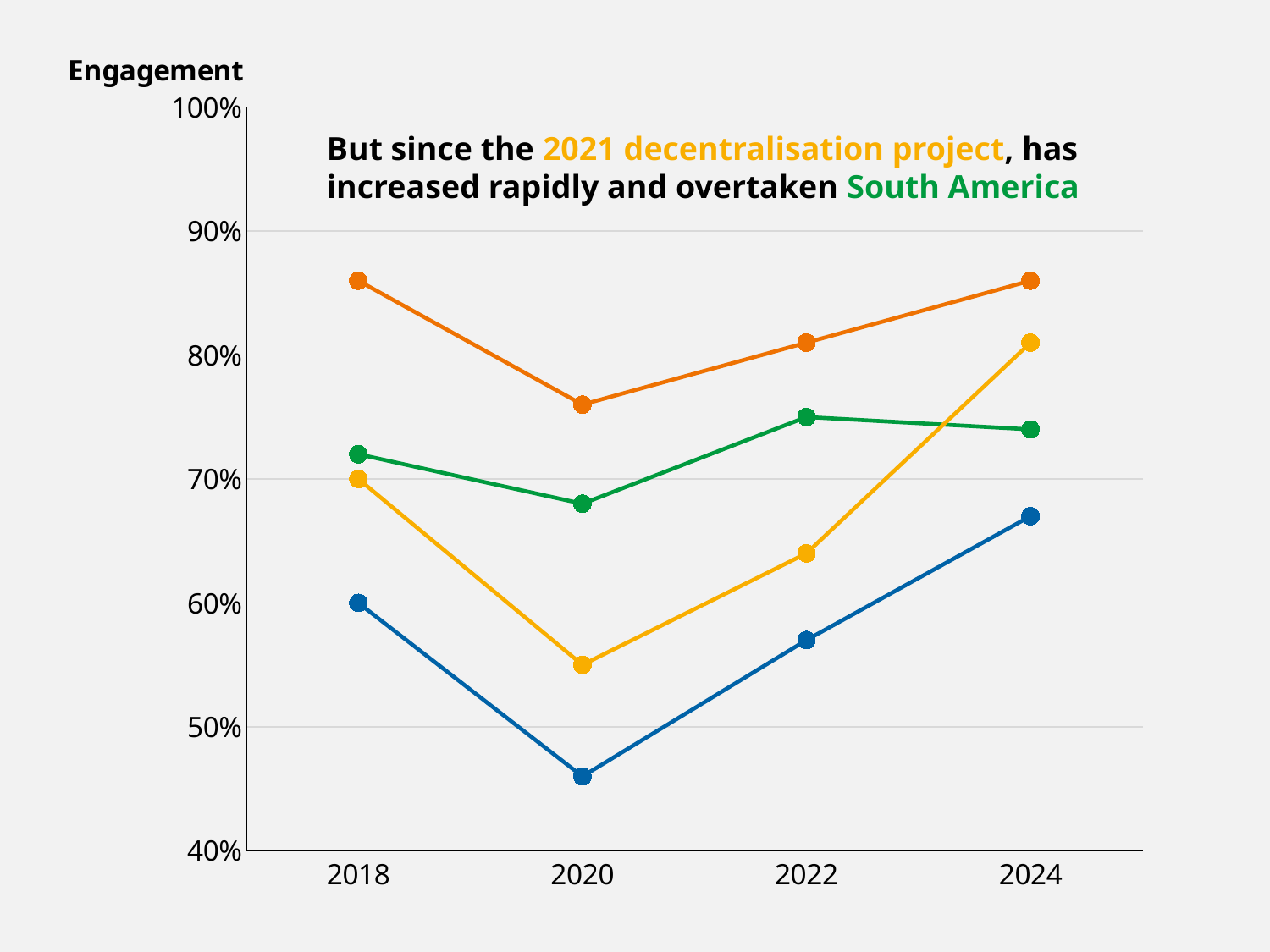
Does the blue line rise or fall from 2020 to 2024? rise What kind of chart is shown on the slide? line chart Is the value of the orange line in 2018 greater or less than 80%? greater How many years are plotted along the x axis? 4 How many lines are plotted on the chart? 4 What is the value of the yellow line in 2018? 70% Which line has the lowest value in 2020? the blue line What is the value of the blue line in 2018? 60% Is the value for South America (green line) in 2018 greater or less than 70%? greater In 2024, which is higher: the yellow line or the South America (green) line? the yellow line Is the value of the yellow line in 2020 greater or less than 60%? less